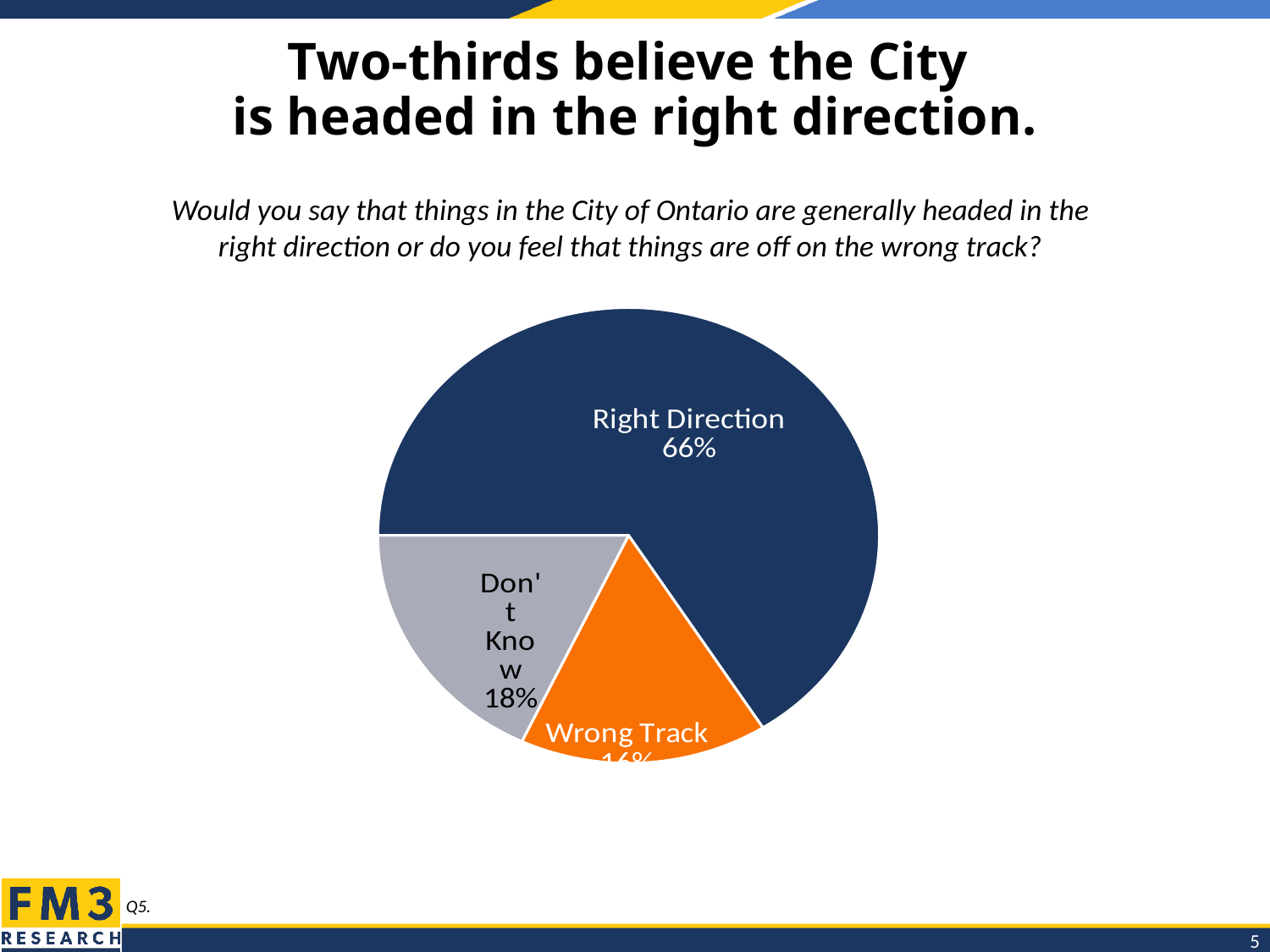
Which response has the largest slice of the pie? Right Direction What percentage of respondents answered Don't Know? 18% What is the title of the slide containing the pie chart? Two-thirds believe the City is headed in the right direction. Which is larger, the Right Direction slice or the Wrong Track slice? Right Direction What kind of chart is shown on the slide? Pie chart What is the difference in percentage points between Right Direction and Don't Know? 48 percentage points How many slices does the pie chart have? 3 What colour is the Wrong Track slice? Orange What percentage of respondents said the City is headed in the Right Direction? 66% What share of the pie does the Right Direction slice represent? 66% Which is larger, the Right Direction slice or the Don't Know slice? Right Direction